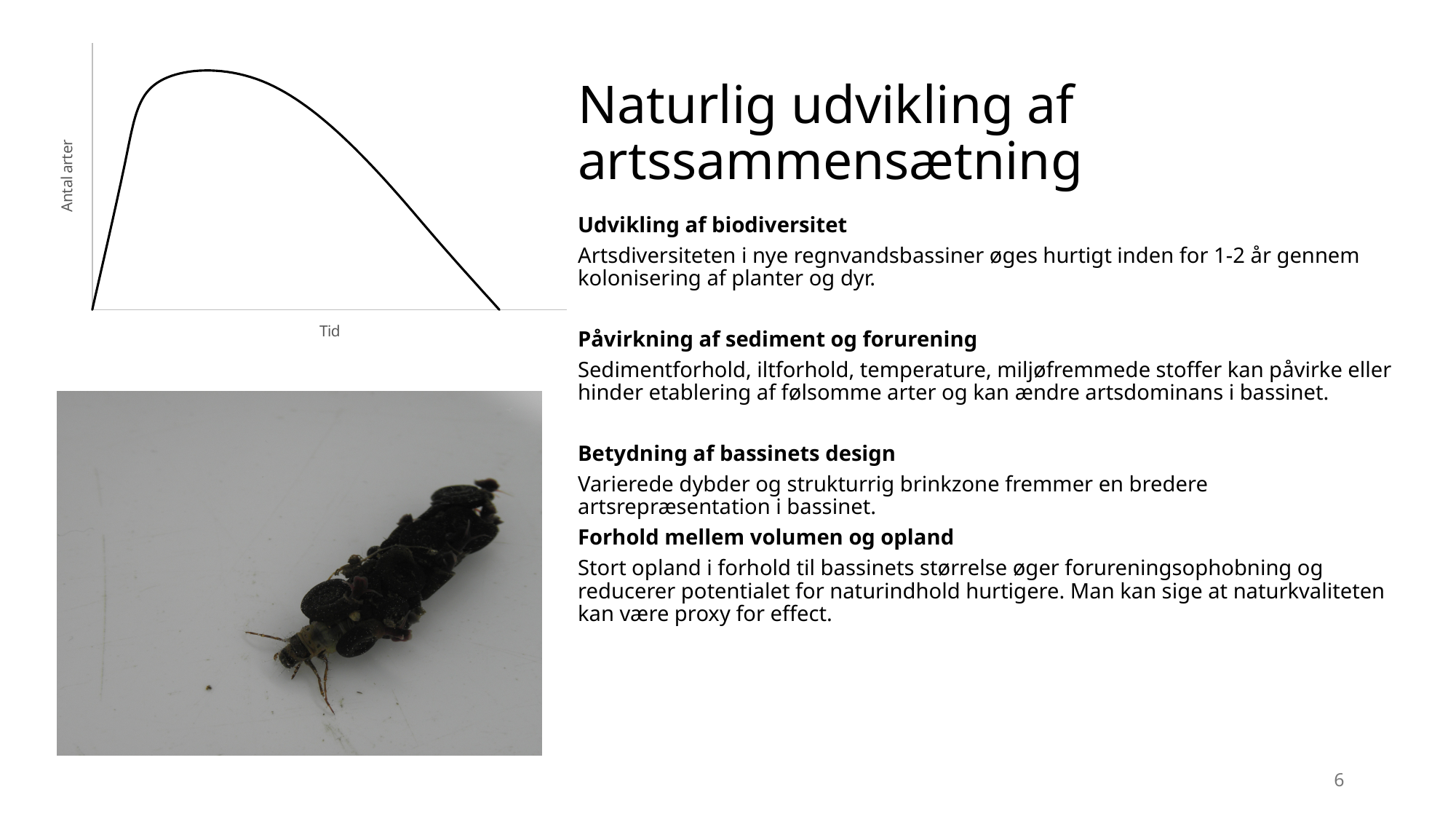
What is the label on the vertical axis of the chart? Antal arter Does the curve in the chart rise or fall at the start of the x axis (Tid)? rise Does the curve in the chart rise or fall toward the right end of the x axis (Tid)? fall What kind of chart is shown in the top-left of the slide? line chart How many lines are plotted in the chart? 1 What is the label on the horizontal axis of the chart? Tid